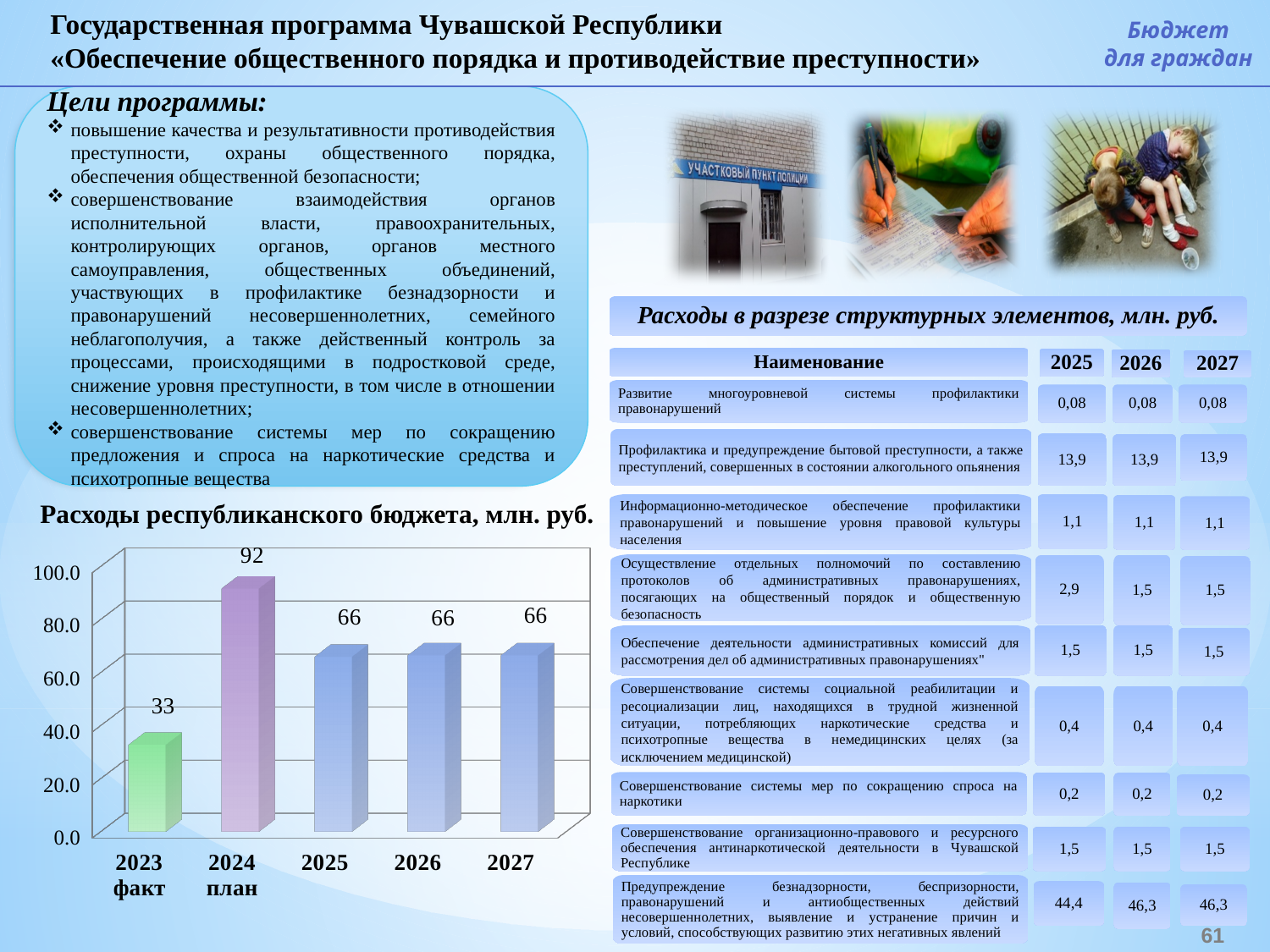
What is the value for 2023 in the chart 'Расходы республиканского бюджета, млн. руб.'? 33 Which year has the highest value in the chart 'Расходы республиканского бюджета, млн. руб.'? 2024 Which year has the lowest value in the chart 'Расходы республиканского бюджета, млн. руб.'? 2023 What is the value for 2024 in the chart 'Расходы республиканского бюджета, млн. руб.'? 92 How many bars are shown in the chart 'Расходы республиканского бюджета, млн. руб.'? 5 What is the difference between the values for 2024 and 2023 in the chart 'Расходы республиканского бюджета, млн. руб.'? 59 In the chart 'Расходы республиканского бюджета, млн. руб.', which year is labelled 'факт'? 2023 What kind of chart is 'Расходы республиканского бюджета, млн. руб.'? bar chart Is the value for 2024 in the chart 'Расходы республиканского бюджета, млн. руб.' greater or less than 80.0? greater What is the value for 2027 in the chart 'Расходы республиканского бюджета, млн. руб.'? 66 Which is larger in the chart 'Расходы республиканского бюджета, млн. руб.': the value for 2023 or the value for 2025? 2025 What is the difference between the values for 2024 and 2025 in the chart 'Расходы республиканского бюджета, млн. руб.'? 26